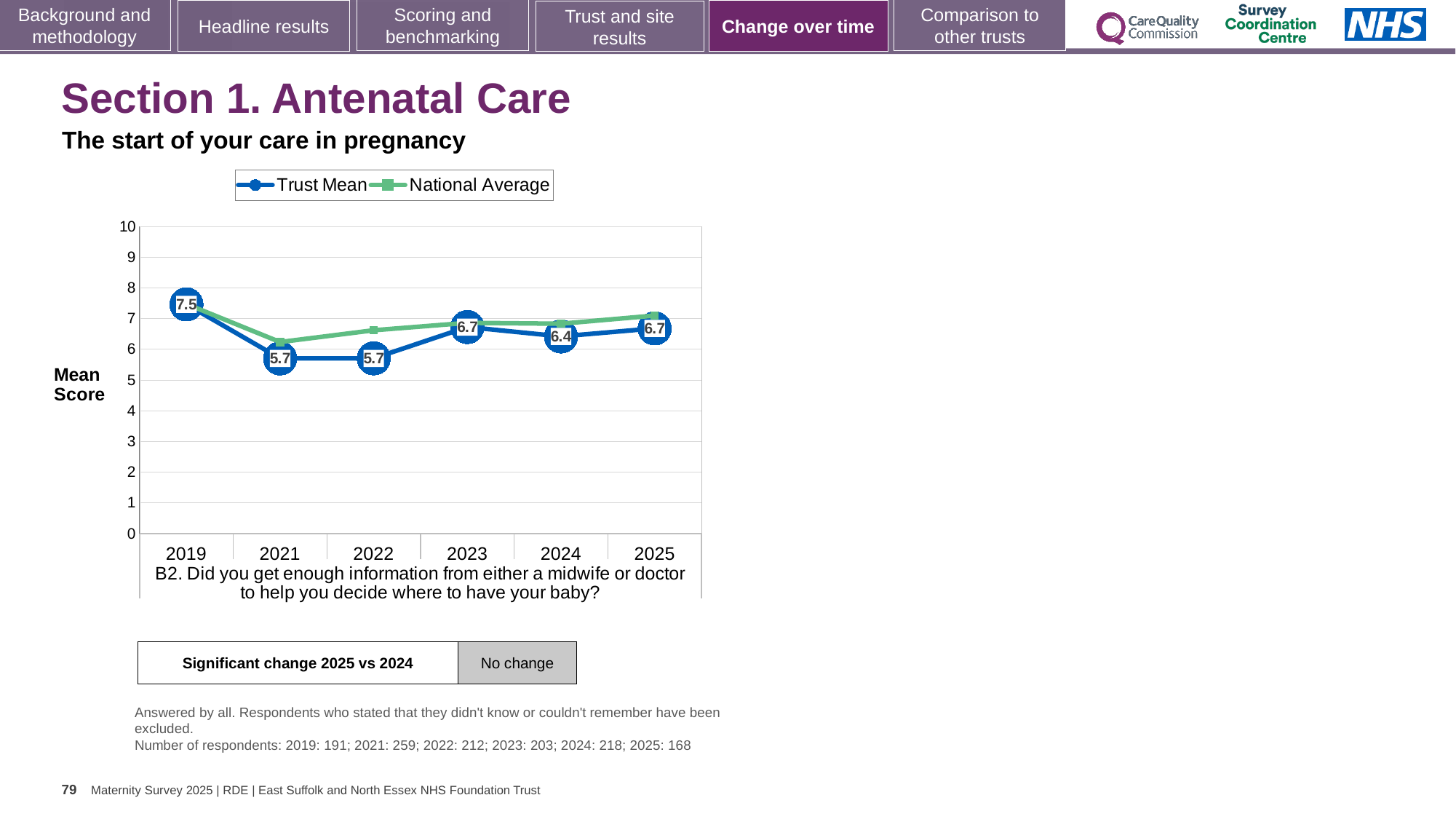
Is the National Average value for 2022 greater or less than 7? less How many years are plotted on the x axis? 6 What kind of chart is shown on the slide? Line chart Which year has the larger Trust Mean, 2023 or 2024? 2023 What is the lowest Trust Mean value shown on the chart? 5.7 Is the National Average value for 2019 greater or less than 7? greater What is the Trust Mean value for 2024? 6.4 What is the Trust Mean value for 2019? 7.5 What is the difference between the Trust Mean in 2019 and in 2021? 1.8 In which year is the Trust Mean highest? 2019 What is the Trust Mean value for 2022? 5.7 How many series does the legend list? 2